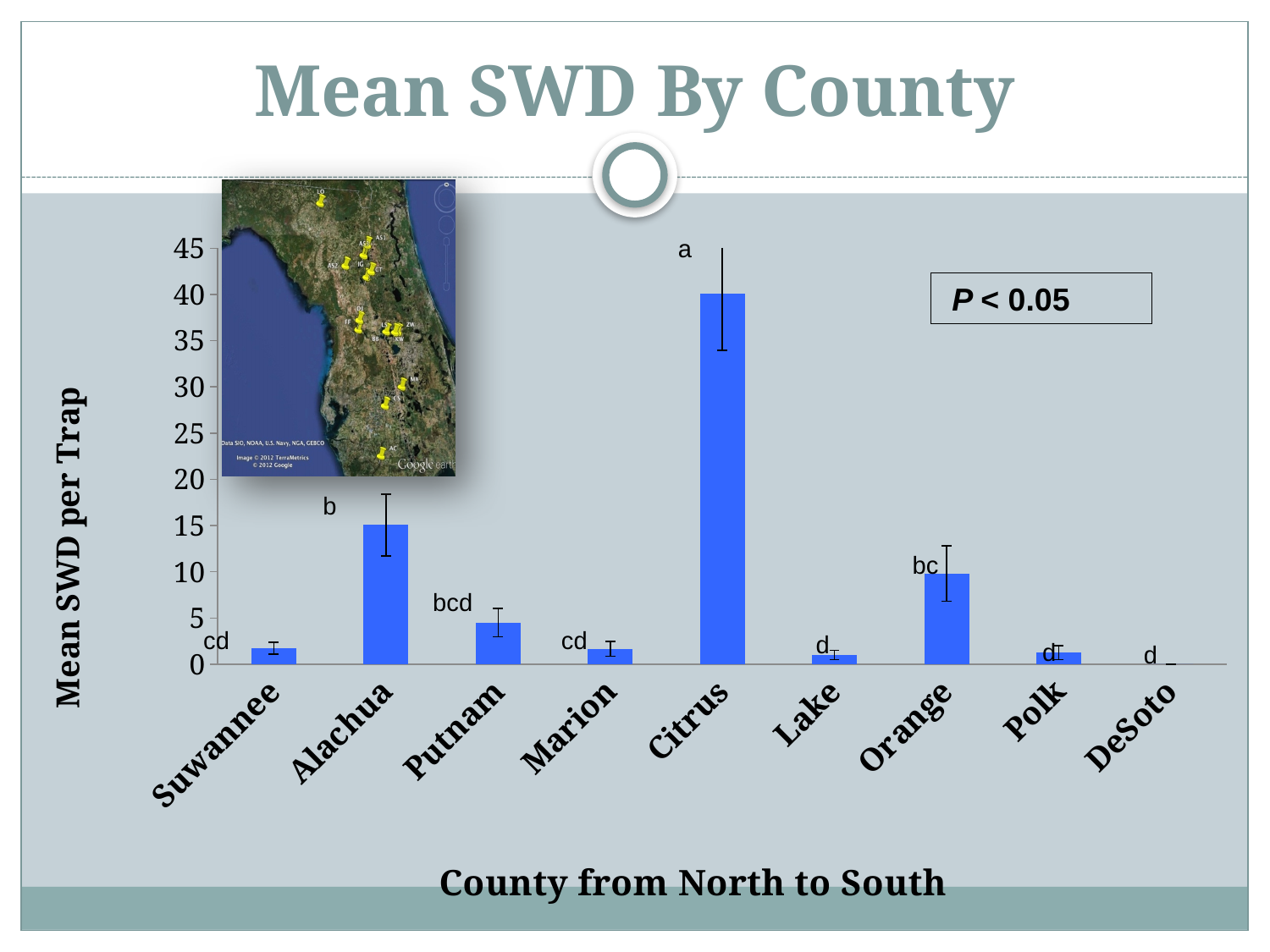
Which county has a higher mean SWD per trap, Putnam or Marion? Putnam Which county has a higher mean SWD per trap, Alachua or Orange? Alachua Is the value for Alachua greater or less than 10? greater Which county has the lowest mean SWD per trap? DeSoto Is the value for Orange greater or less than 5? greater Which county has the highest mean SWD per trap? Citrus How many counties are shown on the x axis of the chart? 9 Is the value for Citrus greater or less than 35? greater What type of chart is shown on the slide? bar chart What is the title of the y axis of the chart? Mean SWD per Trap What is the title of the x axis of the chart? County from North to South